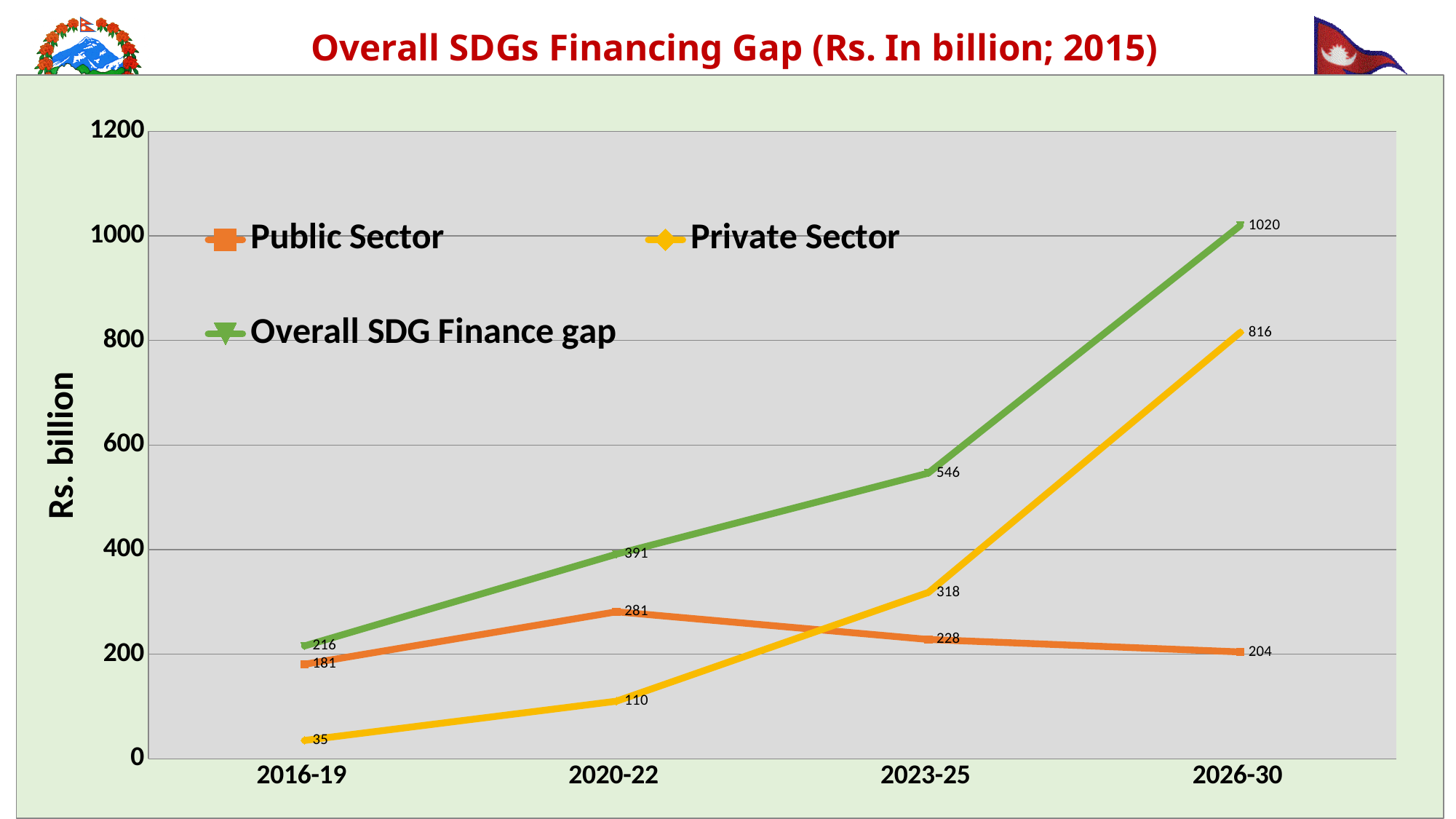
Does the Private Sector series rise or fall from 2016-19 to 2026-30? rise How many periods are shown on the x axis? 4 In which period is the Public Sector value highest? 2020-22 How many series does the legend list? 3 What is the Overall SDG Finance gap value for 2026-30? 1020 In which period is the Private Sector value lowest? 2016-19 Which is larger in 2023-25, the Public Sector value or the Private Sector value? Private Sector What is the difference between the Overall SDG Finance gap and the Private Sector value in 2026-30? 204 What kind of chart is shown on the slide? line chart What is the Public Sector value for 2020-22? 281 What is the Private Sector value for 2016-19? 35 Is the Overall SDG Finance gap value for 2023-25 greater or less than 400? greater